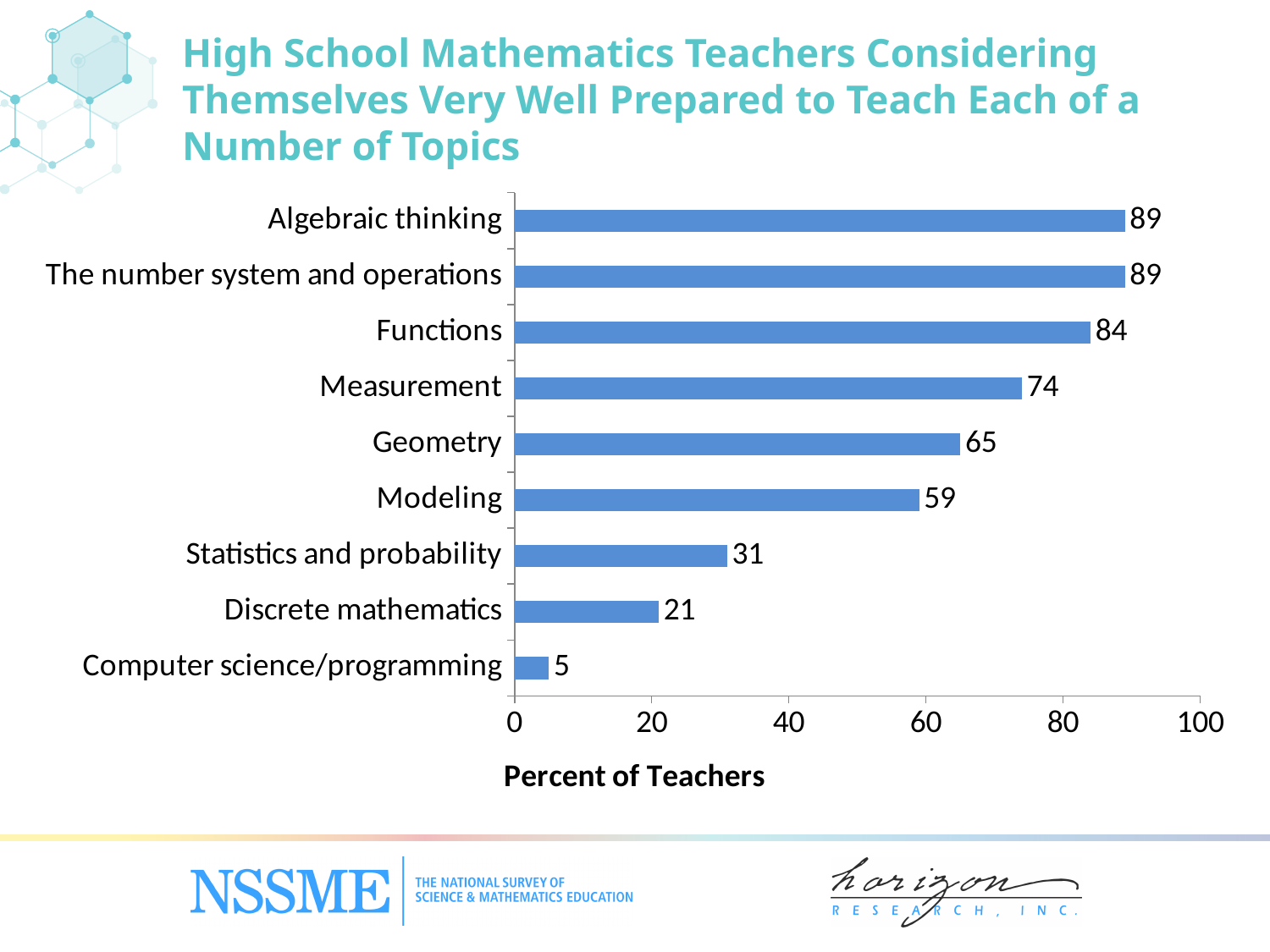
What kind of chart is shown on the slide? bar chart Which topic has the lowest percent of teachers? Computer science/programming What is the value for Discrete mathematics? 21 What is the difference between the values for Statistics and probability and Computer science/programming? 26 Is the value for Measurement greater or less than 60? greater Which is larger, the value for Geometry or the value for Modeling? Geometry What is the value for Geometry? 65 What is the difference between the values for Measurement and Modeling? 15 Which two topics share the highest value of 89? Algebraic thinking and The number system and operations What is the label of the horizontal axis? Percent of Teachers How many topics are shown in the chart? 9 What percent of teachers consider themselves very well prepared to teach Functions? 84